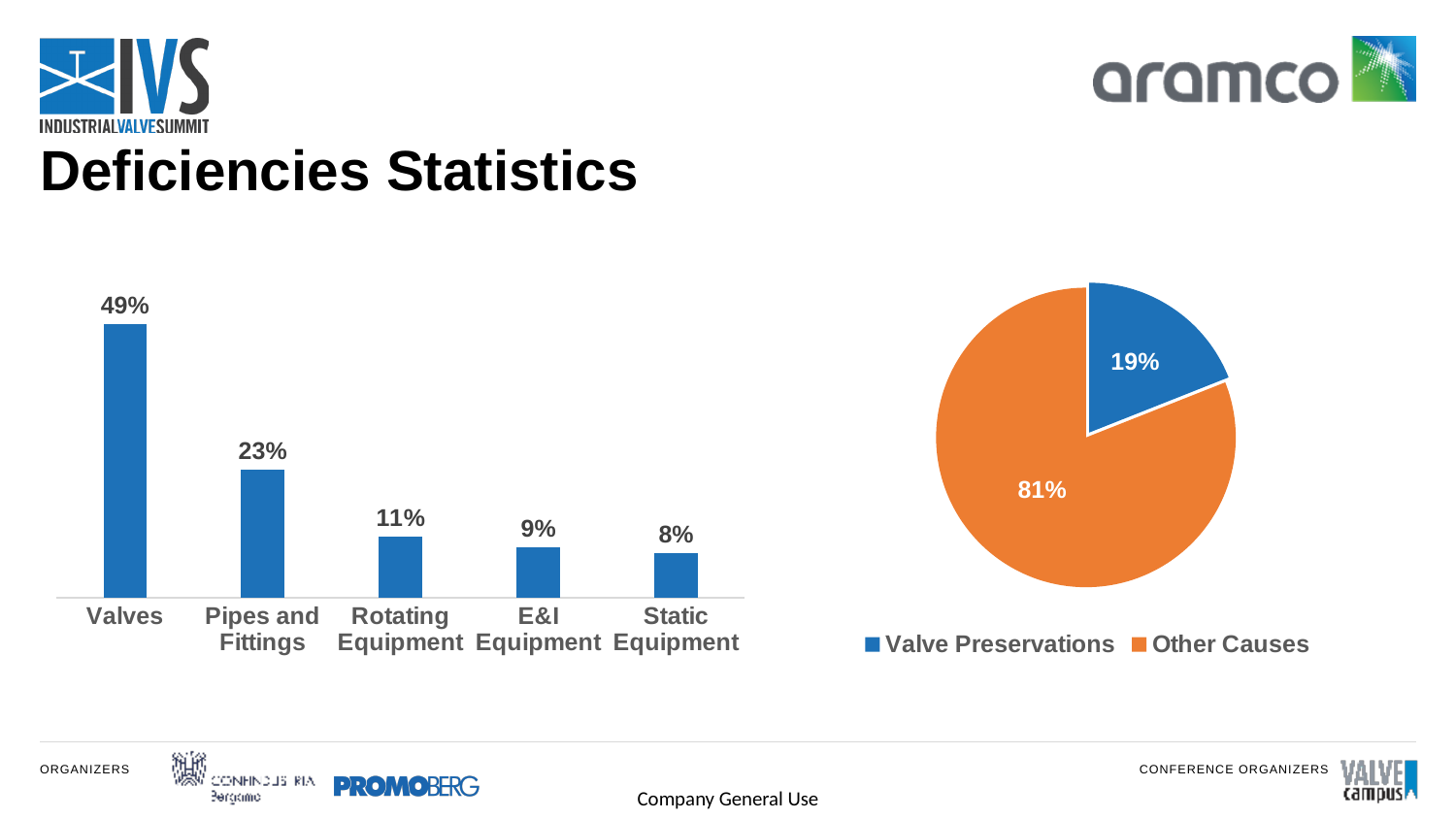
In the bar chart on the left, what is the value for Valves? 49% How many series does the legend of the pie chart on the right list? 2 What kind of chart is on the left of the slide? Bar chart In the pie chart on the right, what share is Valve Preservations? 19% In the bar chart on the left, what is the value for E&I Equipment? 9% How many categories are shown in the bar chart on the left? 5 In the bar chart on the left, which is larger, Rotating Equipment or Static Equipment? Rotating Equipment In the bar chart on the left, do the values rise or fall from left to right? Fall In the bar chart on the left, what is the difference between Valves and Pipes and Fittings? 26% In the bar chart on the left, which category has the lowest value? Static Equipment In the bar chart on the left, which category has the highest value? Valves In the bar chart on the left, what is the value for Pipes and Fittings? 23%